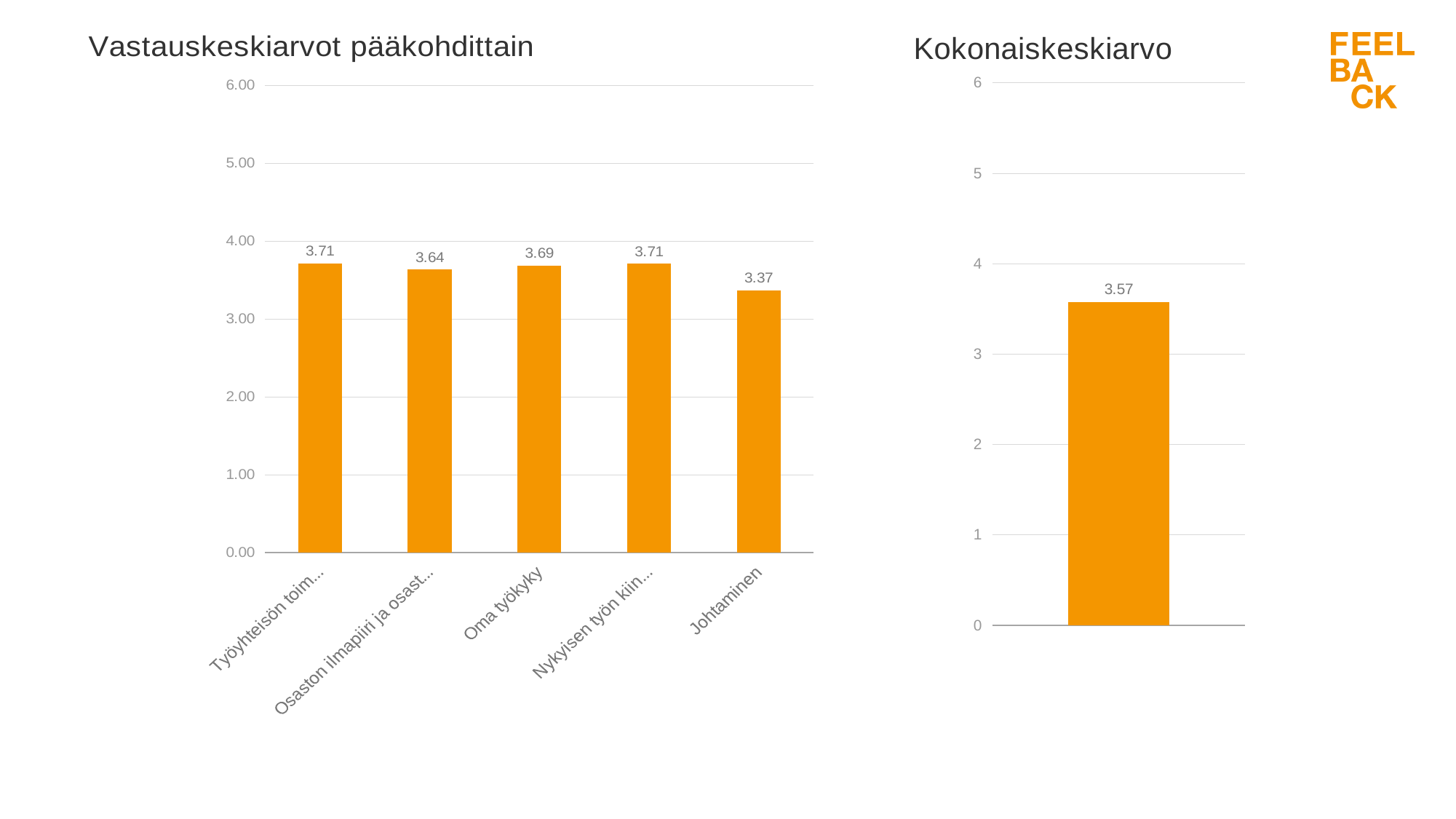
In the 'Vastauskeskiarvot pääkohdittain' chart, which is larger: the value for Oma työkyky or the value for Johtaminen? Oma työkyky In the 'Vastauskeskiarvot pääkohdittain' chart, what is the value for Oma työkyky? 3.69 In the 'Vastauskeskiarvot pääkohdittain' chart, what is the value for Johtaminen? 3.37 In the 'Vastauskeskiarvot pääkohdittain' chart, what is the difference between the values for Oma työkyky and Johtaminen? 0.32 What colour are the bars in the 'Vastauskeskiarvot pääkohdittain' chart? orange How many bars are shown in the 'Kokonaiskeskiarvo' chart? 1 In the 'Kokonaiskeskiarvo' chart, is the value of the bar greater or less than 3? greater In the 'Vastauskeskiarvot pääkohdittain' chart, is the value for Johtaminen greater or less than 4.00? less What kind of chart is the 'Vastauskeskiarvot pääkohdittain' chart? bar chart In the 'Vastauskeskiarvot pääkohdittain' chart, which category has the lowest value? Johtaminen In the 'Kokonaiskeskiarvo' chart, what is the value of the bar? 3.57 How many categories are shown in the 'Vastauskeskiarvot pääkohdittain' chart? 5